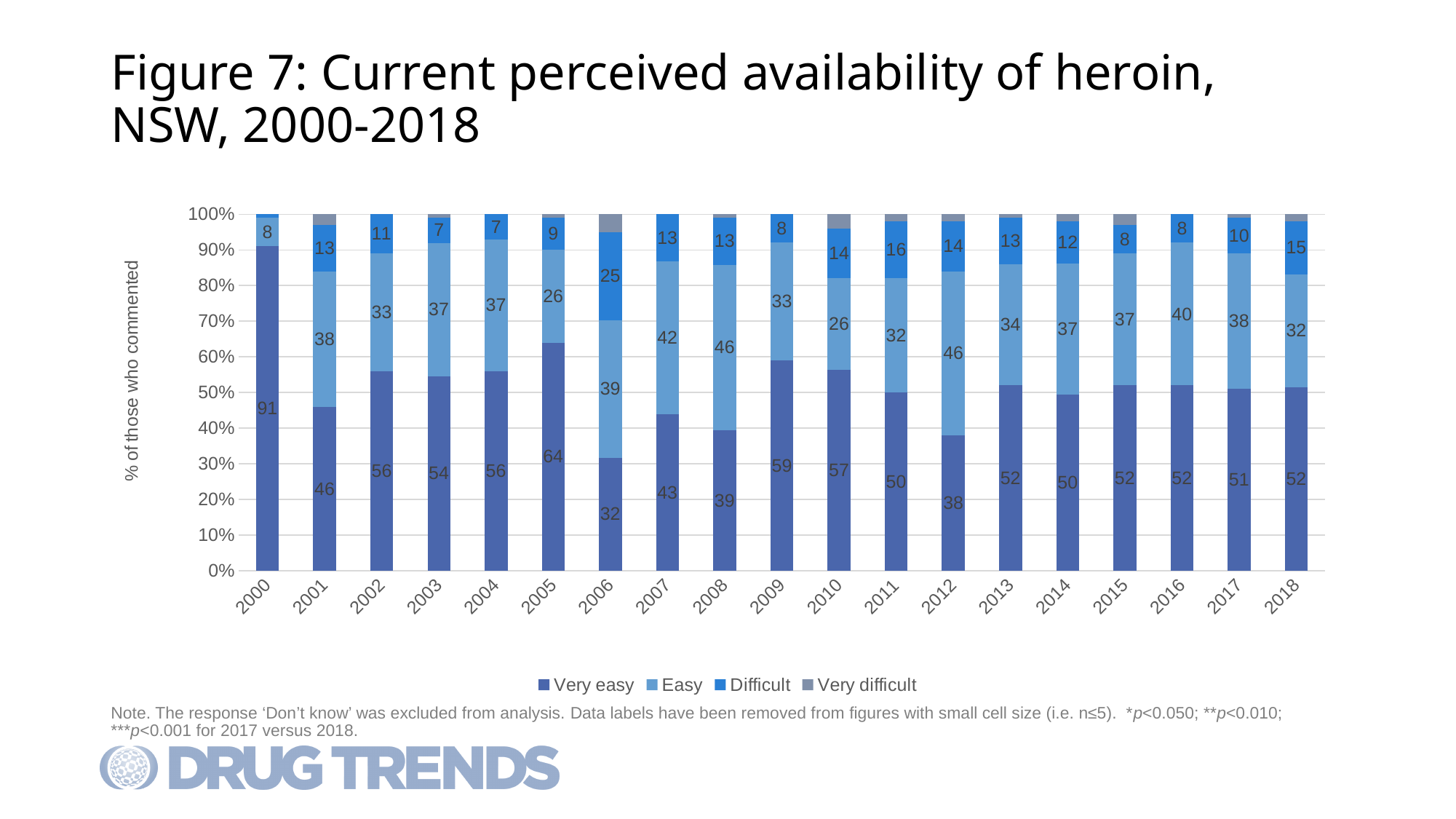
What percentage of those who commented rated heroin as 'Very easy' to obtain in 2000? 91 In which year is the 'Very easy' value lowest? 2006 Which year has the larger 'Easy' value, 2016 or 2018? 2016 What is the 'Easy' value for 2012? 46 In which year is the 'Difficult' value highest? 2006 How many series does the legend list? 4 In which year is the 'Very easy' value highest? 2000 What kind of chart is shown on the slide? Stacked bar chart How many years are shown on the x axis? 19 What is the 'Difficult' value for 2006? 25 What is the difference between the 'Easy' value in 2008 and the 'Easy' value in 2010? 20 What is the 'Easy' value for 2007? 42